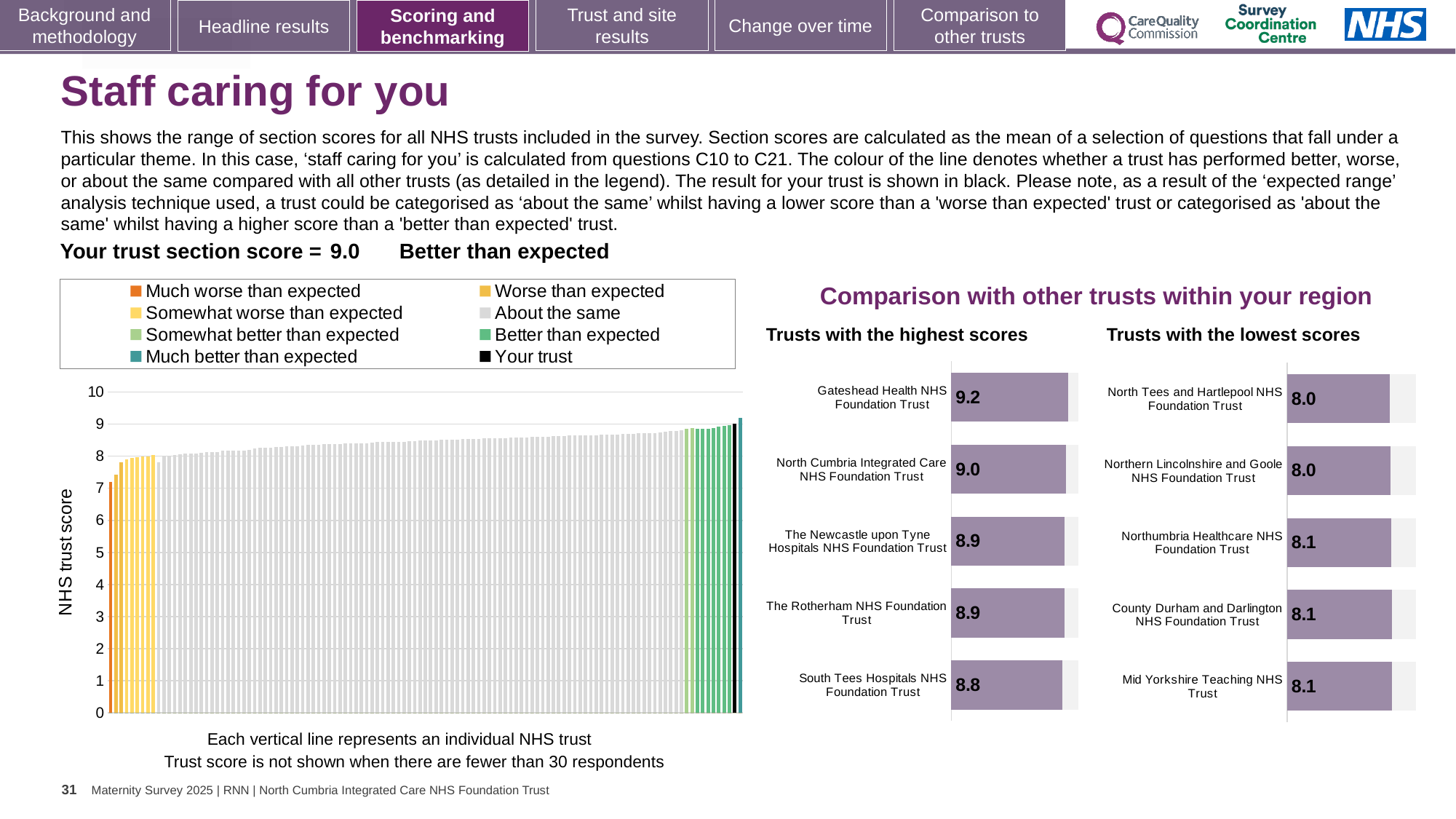
What kind of chart is the main chart on the left showing NHS trust scores? Bar chart How many entries does the legend of the main NHS trust score chart list? 8 In the 'Trusts with the highest scores' chart, what is the score for South Tees Hospitals NHS Foundation Trust? 8.8 In the 'Trusts with the highest scores' chart, what is the difference between the scores of Gateshead Health NHS Foundation Trust and South Tees Hospitals NHS Foundation Trust? 0.4 In the 'Trusts with the highest scores' chart, what is the score for Gateshead Health NHS Foundation Trust? 9.2 In the 'Trusts with the highest scores' chart, which trust has the highest score? Gateshead Health NHS Foundation Trust How many trusts are shown in the 'Trusts with the lowest scores' chart? 5 In the 'Trusts with the lowest scores' chart, what is the difference between the scores of Mid Yorkshire Teaching NHS Trust and North Tees and Hartlepool NHS Foundation Trust? 0.1 Which has a higher score: Gateshead Health NHS Foundation Trust in the highest-scores chart or Mid Yorkshire Teaching NHS Trust in the lowest-scores chart? Gateshead Health NHS Foundation Trust In the 'Trusts with the highest scores' chart, which trust has the lowest score? South Tees Hospitals NHS Foundation Trust In the main NHS trust score chart on the left, do the values rise or fall from left to right? Rise In the 'Trusts with the lowest scores' chart, what is the score for Northumbria Healthcare NHS Foundation Trust? 8.1